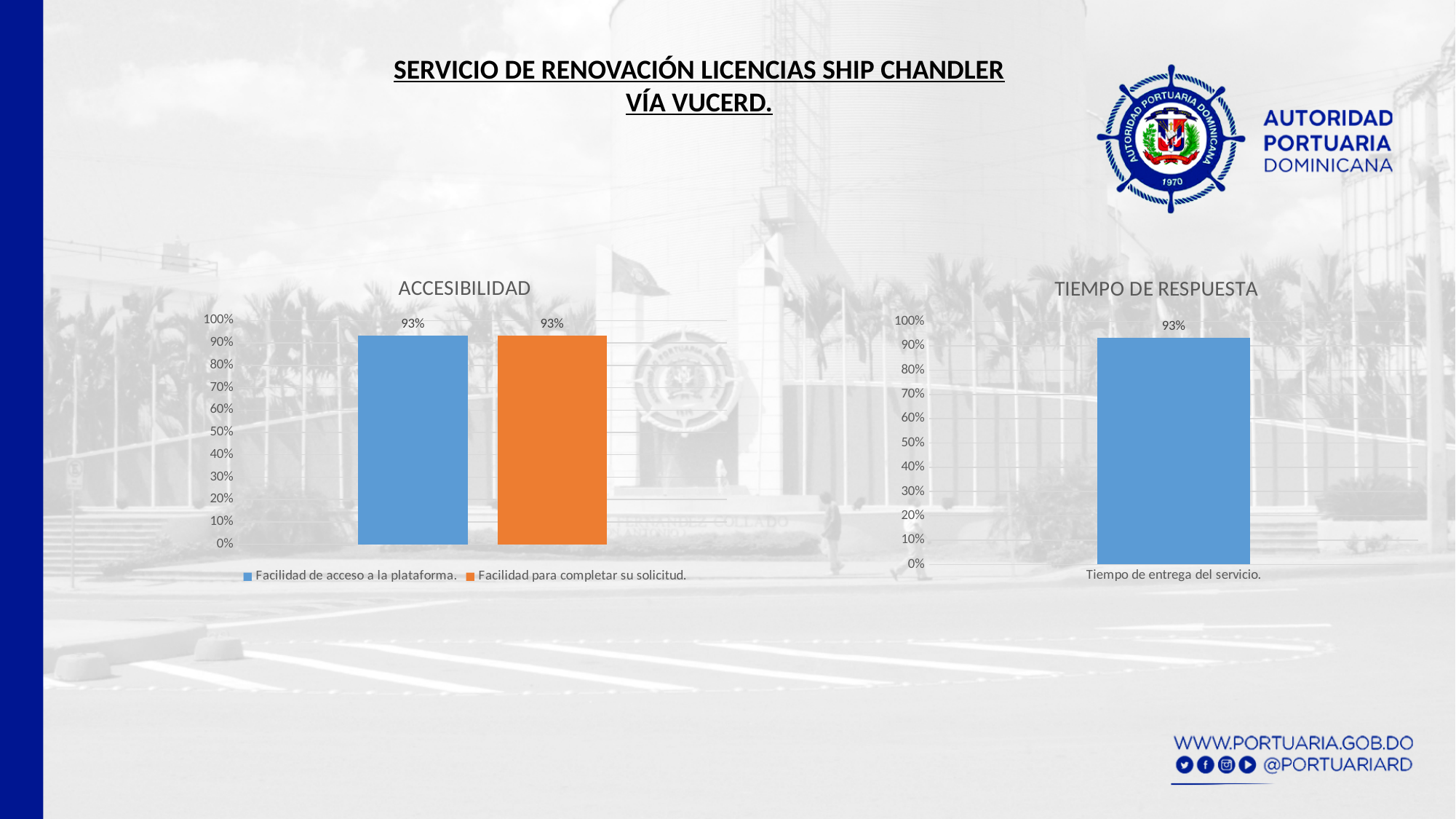
In the ACCESIBILIDAD chart, how many bars are plotted? 2 What is the title of the chart on the right side of the slide? TIEMPO DE RESPUESTA In the TIEMPO DE RESPUESTA chart, is the value for "Tiempo de entrega del servicio." greater or less than 50%? greater In the TIEMPO DE RESPUESTA chart, how many bars are plotted? 1 In the TIEMPO DE RESPUESTA chart, what is the value for "Tiempo de entrega del servicio."? 93% In the ACCESIBILIDAD chart, what is the value for "Facilidad para completar su solicitud."? 93% In the ACCESIBILIDAD chart, what is the value for "Facilidad de acceso a la plataforma."? 93% In the ACCESIBILIDAD chart, how many series does the legend list? 2 What kind of chart is the TIEMPO DE RESPUESTA chart? Bar chart What kind of chart is the ACCESIBILIDAD chart? Bar chart In the ACCESIBILIDAD chart, what is the difference between the values for "Facilidad de acceso a la plataforma." and "Facilidad para completar su solicitud."? 0% In the ACCESIBILIDAD chart, what colour is the bar for "Facilidad para completar su solicitud."? Orange